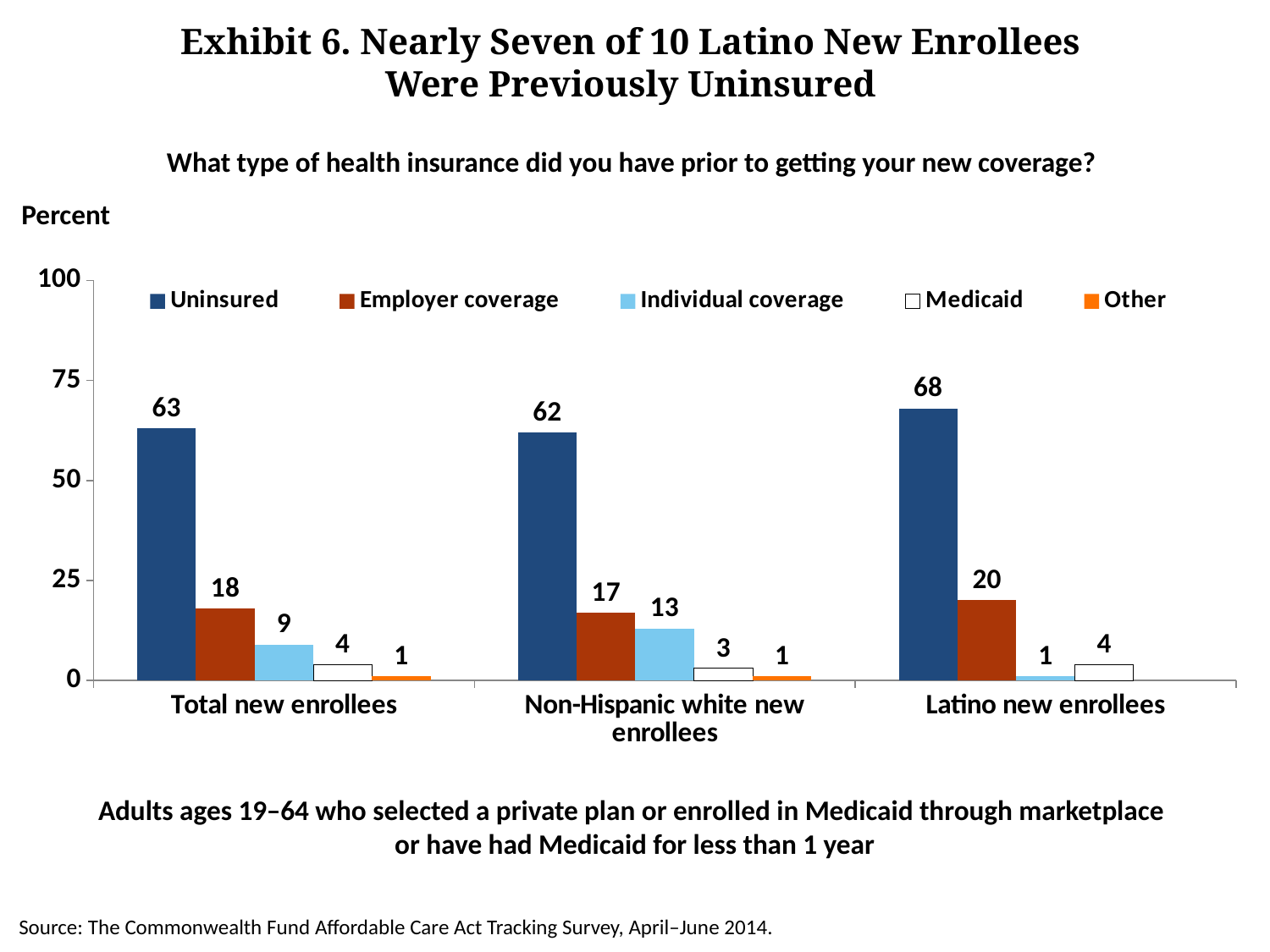
What percentage of Latino new enrollees were previously uninsured? 68 Which group has the highest Uninsured value? Latino new enrollees What is the difference between the Uninsured values for Latino new enrollees and Non-Hispanic white new enrollees? 6 Which group has the lowest Individual coverage value? Latino new enrollees How many enrollee groups are shown on the x axis? 3 What is the value for Employer coverage among Non-Hispanic white new enrollees? 17 What is the value for Individual coverage among Total new enrollees? 9 Which is larger: Individual coverage for Non-Hispanic white new enrollees or Individual coverage for Total new enrollees? Non-Hispanic white new enrollees What kind of chart is shown on the slide? bar chart Which legend entry is shown in orange? Other Is the Uninsured value for Total new enrollees greater or less than 50? greater How many series does the legend list? 5